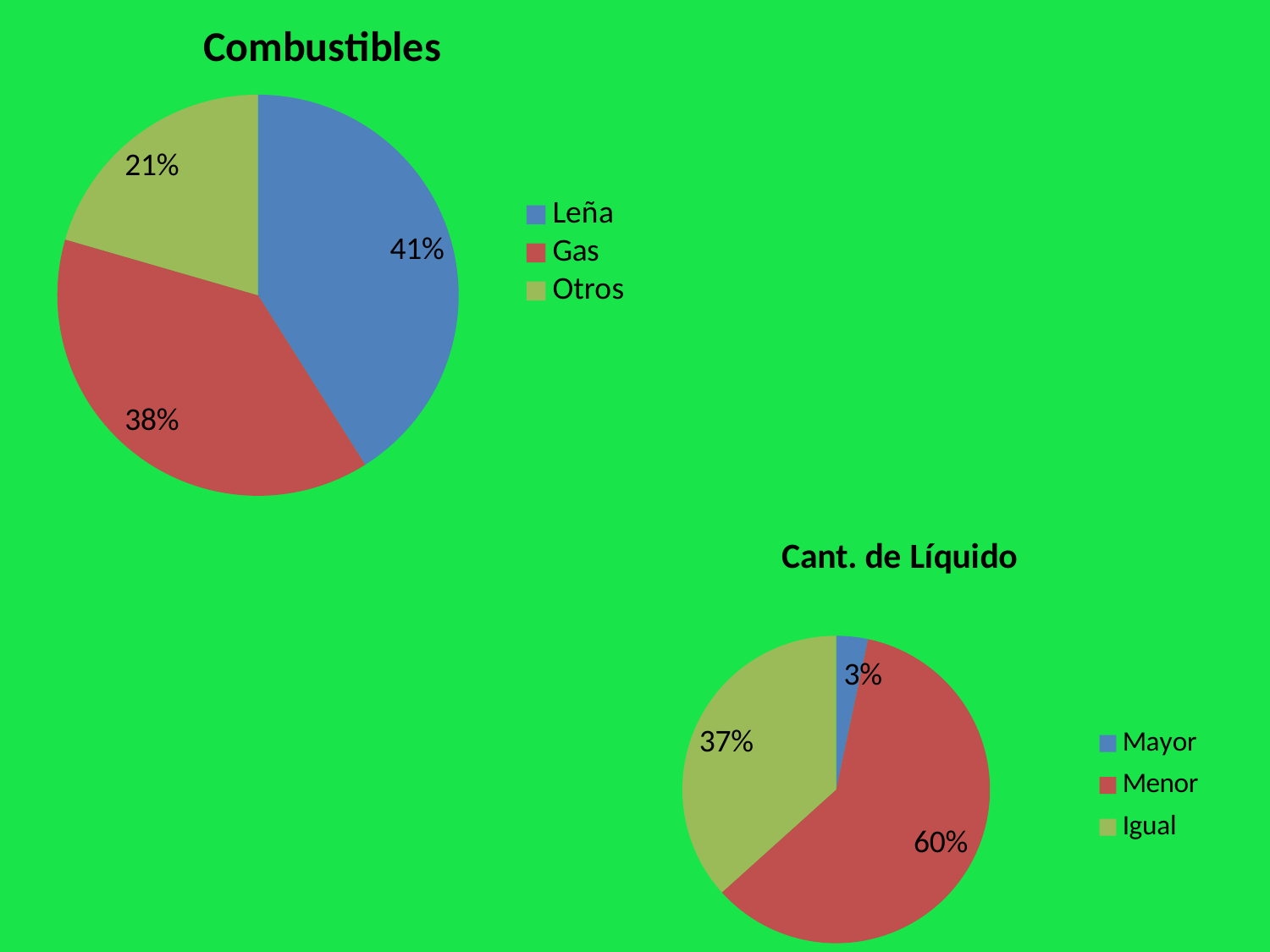
In the 'Combustibles' chart, which category has the smallest slice? Otros In the 'Cant. de Líquido' chart, which category has the largest slice? Menor In the 'Combustibles' chart, what is the difference between the Leña and Otros shares? 20% In the 'Combustibles' chart, what share does Otros have? 21% In the 'Combustibles' chart, how many slices does the pie have? 3 What type of chart is the 'Cant. de Líquido' chart? Pie chart In the 'Cant. de Líquido' chart, what share does Mayor have? 3% In the 'Combustibles' chart, what share does Gas have? 38% In the 'Combustibles' chart, what share does Leña have? 41% In the 'Cant. de Líquido' chart, what is the difference between the Menor and Igual shares? 23% In the 'Cant. de Líquido' chart, which is larger, Igual or Mayor? Igual In the 'Cant. de Líquido' chart, what share does Menor have? 60%